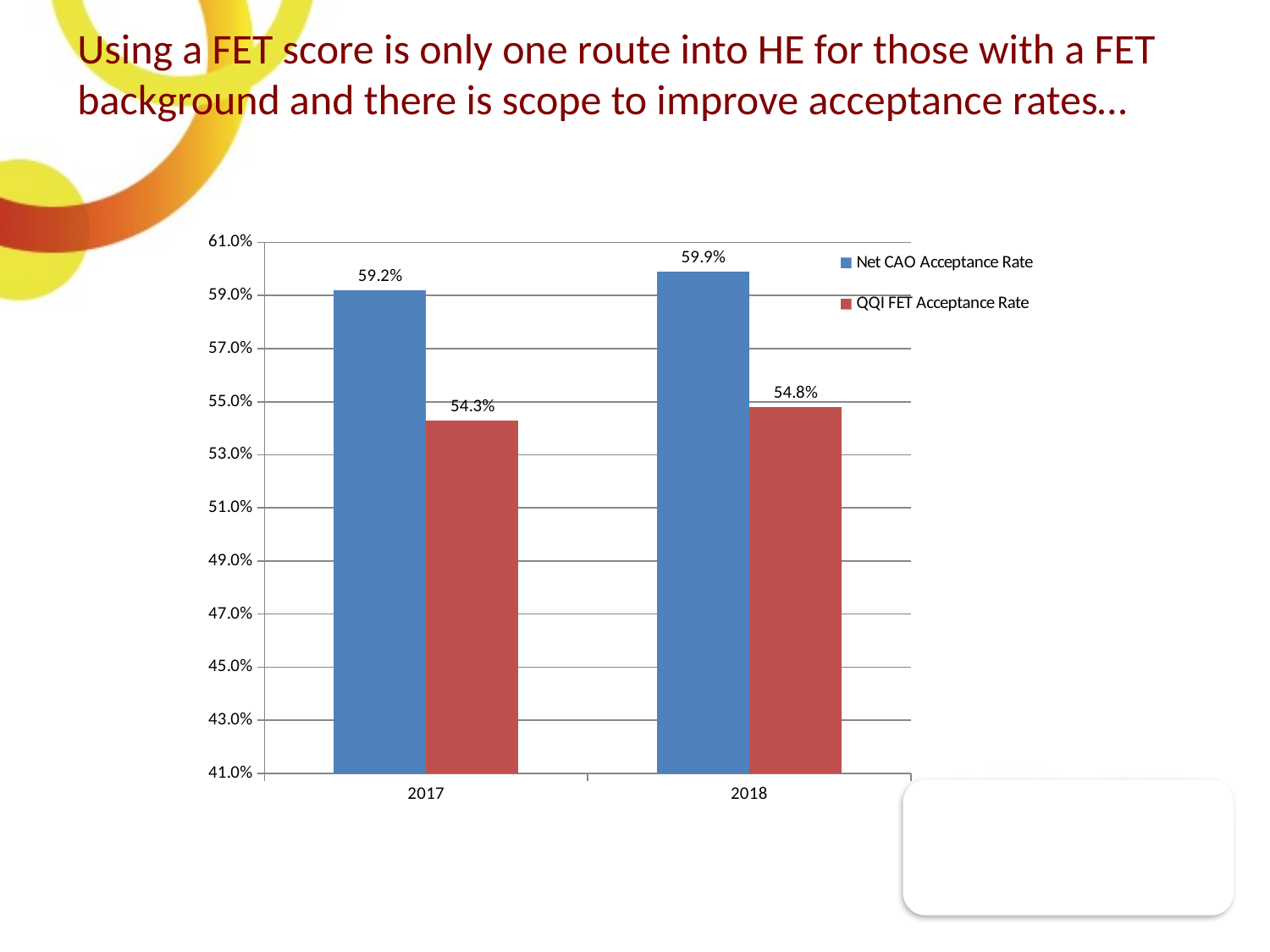
Which is larger in 2018, the Net CAO Acceptance Rate or the QQI FET Acceptance Rate? Net CAO Acceptance Rate What is the Net CAO Acceptance Rate for 2018? 59.9% What is the Net CAO Acceptance Rate for 2017? 59.2% What kind of chart is shown on the slide? Bar chart What is the difference between the Net CAO Acceptance Rate and the QQI FET Acceptance Rate in 2017? 4.9% What is the QQI FET Acceptance Rate for 2018? 54.8% Which year has the higher Net CAO Acceptance Rate? 2018 Does the QQI FET Acceptance Rate rise or fall from 2017 to 2018? Rise How many years are shown on the x axis? 2 How many series does the legend list? 2 What is the QQI FET Acceptance Rate for 2017? 54.3% Which year has the lower QQI FET Acceptance Rate? 2017